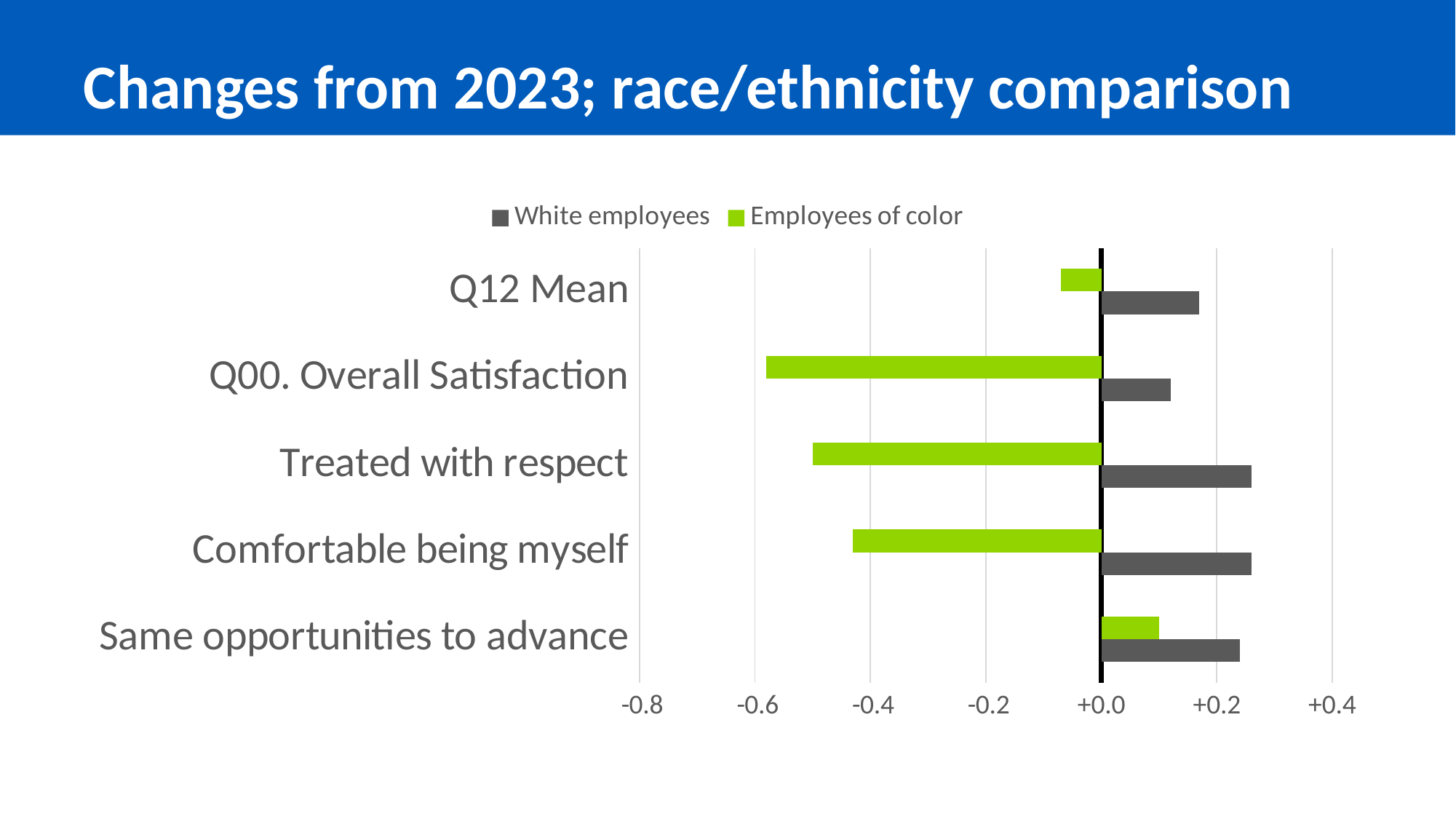
Which category has the highest value for Employees of color? Same opportunities to advance Is the value for Employees of color on Q00. Overall Satisfaction greater or less than -0.4? less Is the value for White employees on Treated with respect greater or less than +0.2? greater For Same opportunities to advance, which series has the larger value, White employees or Employees of color? White employees Which category has the lowest value for White employees? Q00. Overall Satisfaction For Q12 Mean, which series has the larger value, White employees or Employees of color? White employees How many categories are plotted on the chart? 5 Which category has the lowest value for Employees of color? Q00. Overall Satisfaction Is the value for White employees on Q12 Mean greater or less than +0.2? less What kind of chart is shown on the slide? bar chart How many series does the legend list? 2 What colour represents Employees of color in the chart? green